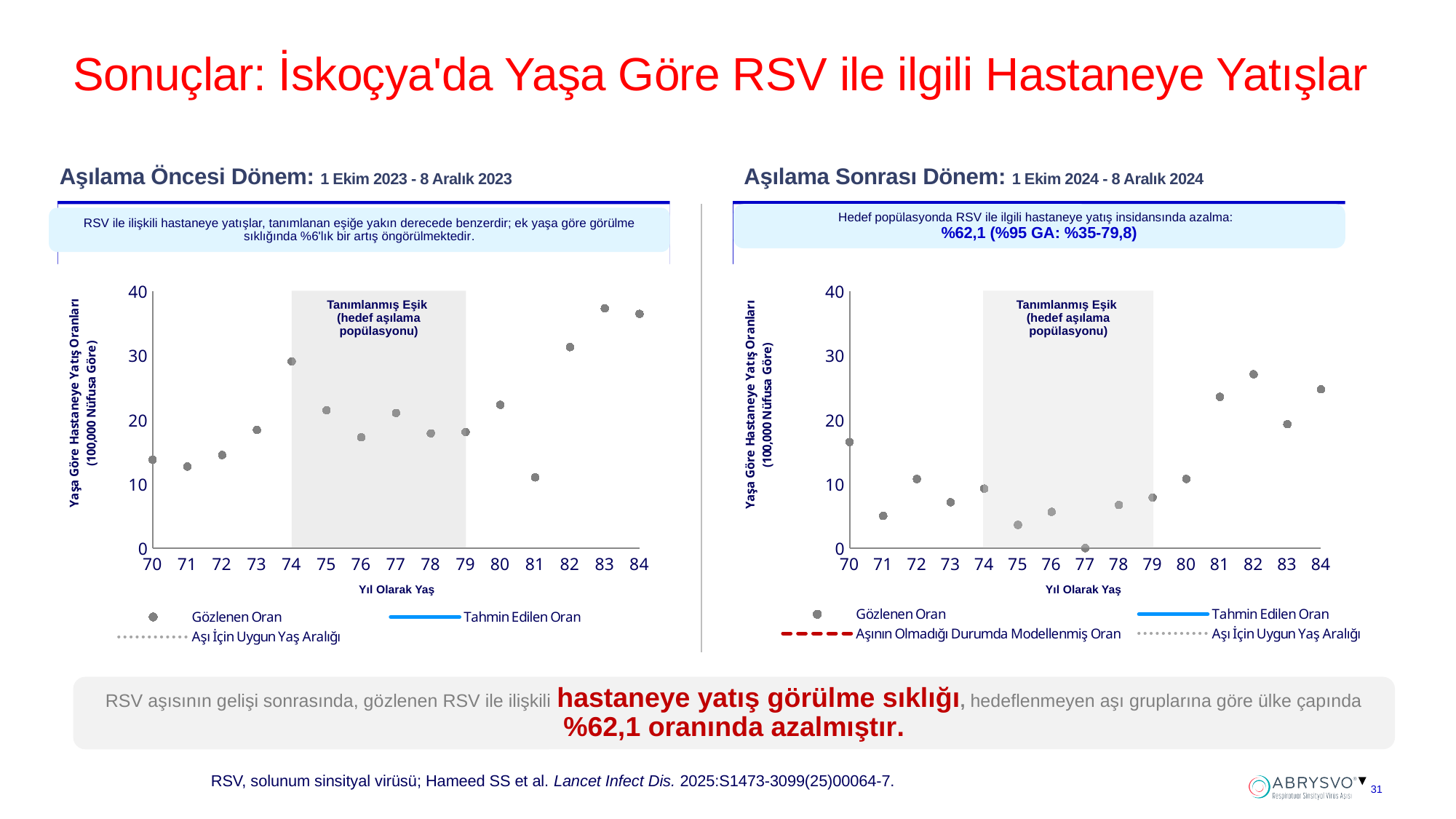
In the 'Aşılama Öncesi Dönem' chart on the left, is the observed rate for age 74 greater or less than 20? greater In the 'Aşılama Sonrası Dönem' chart on the right, which age has the lowest observed rate? 77 In the 'Aşılama Öncesi Dönem' chart on the left, how many age categories are shown on the x axis? 15 What kind of chart is the 'Aşılama Öncesi Dönem' chart on the left? scatter chart In the 'Aşılama Sonrası Dönem' chart on the right, do the observed rates rise or fall from age 80 to age 82? rise In the 'Aşılama Sonrası Dönem' chart on the right, is the observed rate for age 81 greater or less than 20? greater In the 'Aşılama Sonrası Dönem' chart on the right, is the observed rate for age 75 greater or less than 10? less In the 'Aşılama Sonrası Dönem' chart on the right, how many entries does the legend list? 4 In the 'Aşılama Öncesi Dönem' chart on the left, how many entries does the legend list? 3 In the 'Aşılama Öncesi Dönem' chart on the left, which age has the lowest observed rate? 81 What label is printed inside the shaded region of the 'Aşılama Öncesi Dönem' chart on the left? Tanımlanmış Eşik (hedef aşılama popülasyonu) In the 'Aşılama Öncesi Dönem' chart on the left, which has the higher observed rate, age 74 or age 81? age 74